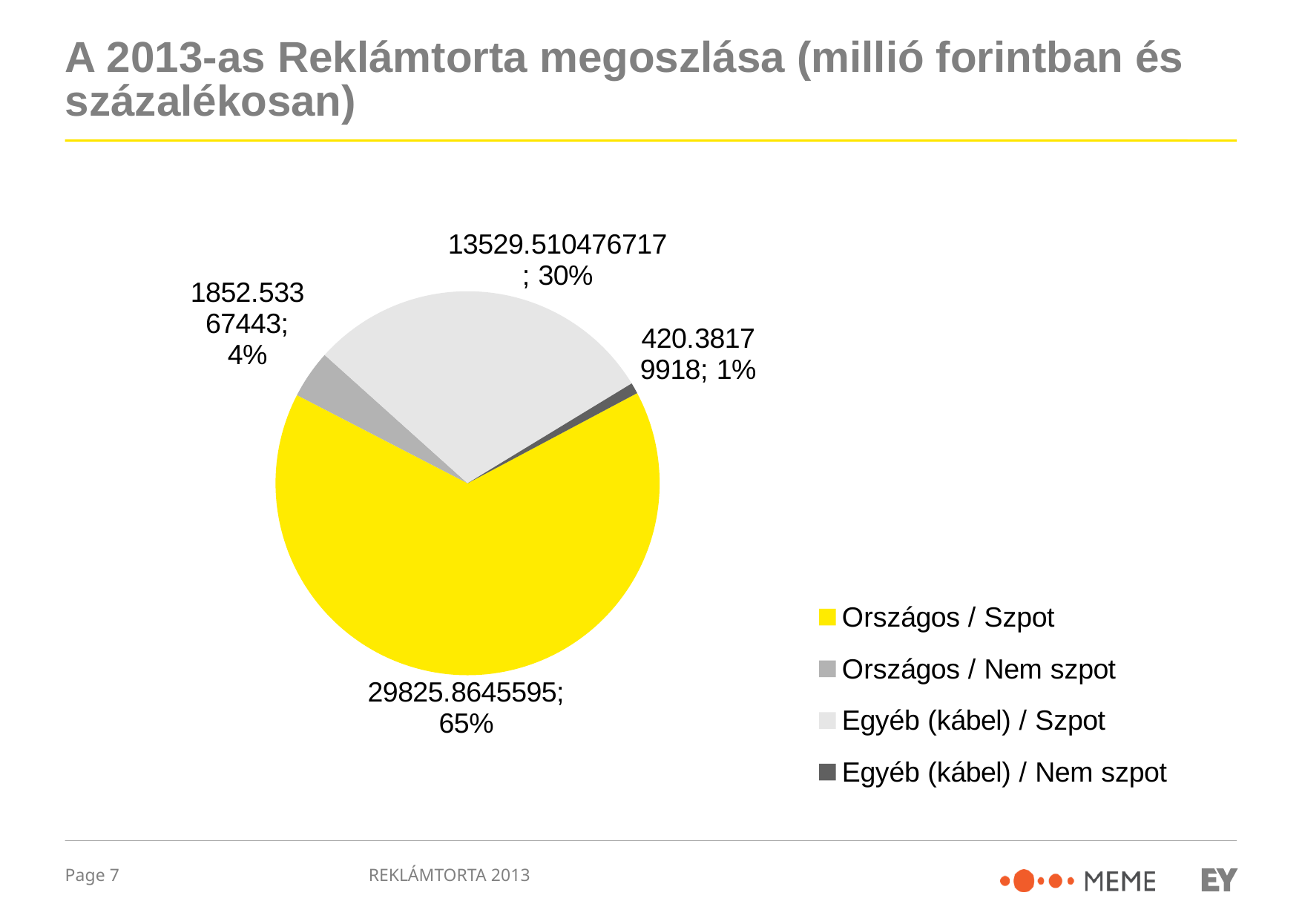
Which is larger, the Országos / Nem szpot slice or the Egyéb (kábel) / Szpot slice? Egyéb (kábel) / Szpot What value is printed for the Országos / Szpot slice? 29825.8645595 How many entries does the legend list? 4 What percentage share does the Egyéb (kábel) / Nem szpot slice have? 1% What percentage share does the Országos / Szpot slice have? 65% What percentage share does the Egyéb (kábel) / Szpot slice have? 30% Which category has the smallest slice of the pie? Egyéb (kábel) / Nem szpot How many slices does the pie chart have? 4 Which category has the largest slice of the pie? Országos / Szpot What kind of chart is shown on the slide? pie chart What value is printed for the Egyéb (kábel) / Szpot slice? 13529.510476717